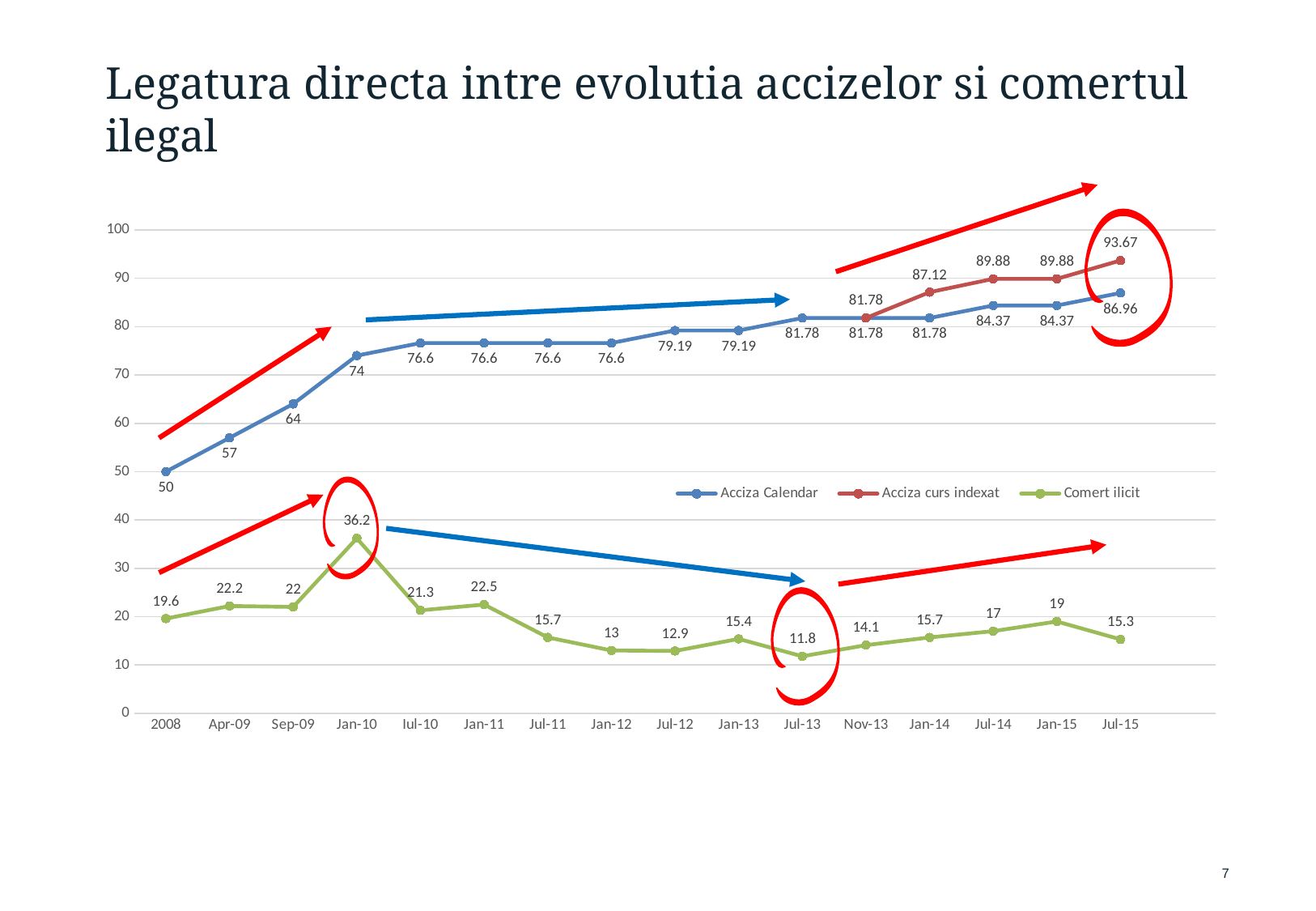
What is the value of Comert ilicit at Jan-10? 36.2 Which is larger at Jan-14: Acciza curs indexat or Acciza Calendar? Acciza curs indexat What is the difference between Comert ilicit at Jan-15 and at Jul-15? 3.7 What is the value of Acciza Calendar at 2008? 50 How many points are on the x axis? 16 At which x-axis point is Comert ilicit highest? Jan-10 What type of chart is shown on the slide? line chart At which x-axis point is Comert ilicit lowest? Jul-13 Does Acciza Calendar rise or fall from 2008 to Jul-15? rise What is the value of Acciza curs indexat at Jul-15? 93.67 How many series does the legend list? 3 What is the difference between Acciza curs indexat and Acciza Calendar at Jul-15? 6.71